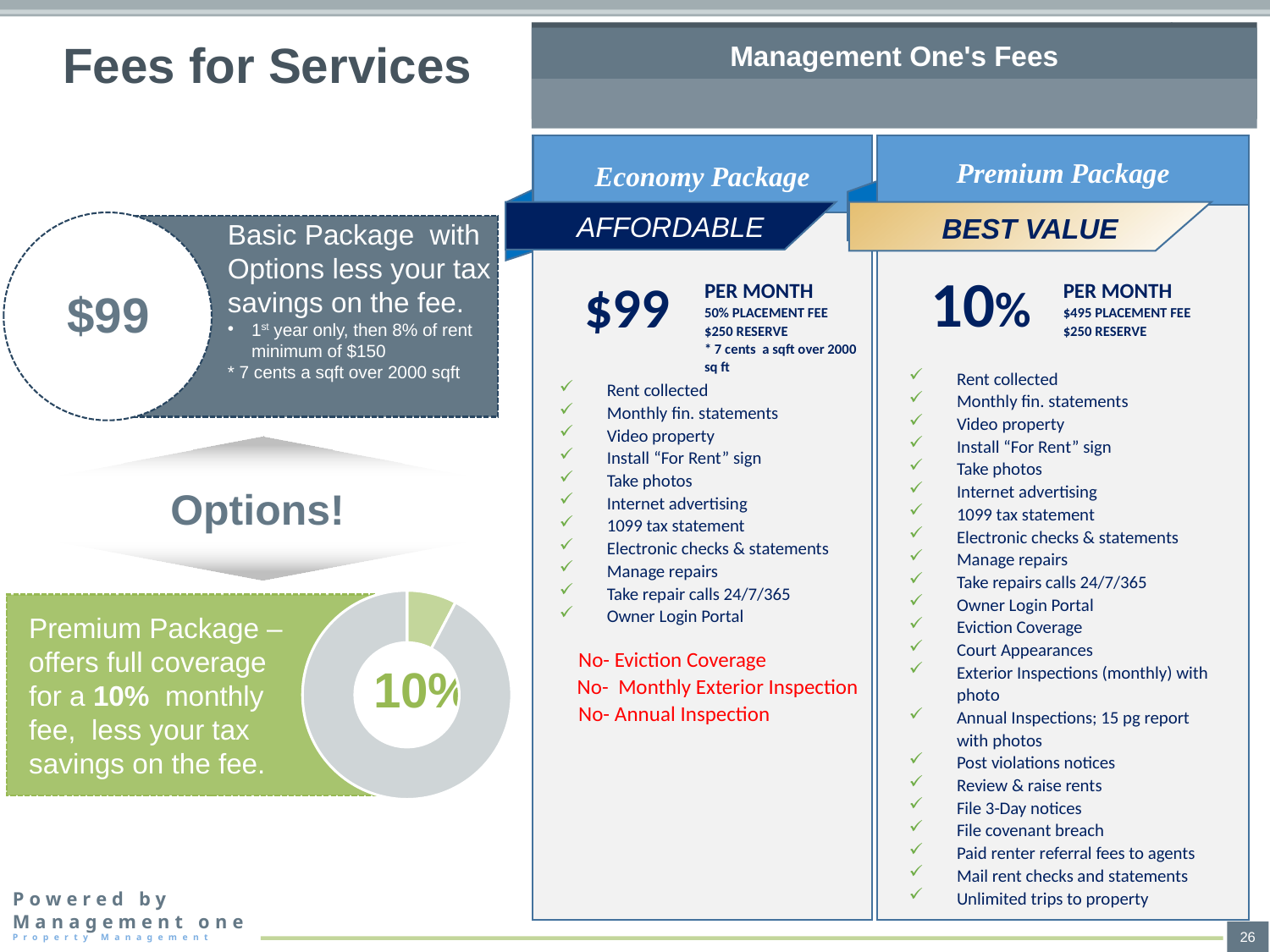
What value is printed in the centre of the doughnut chart? 10% What colour is the smaller slice of the doughnut chart? green How many slices does the doughnut chart have? 2 Which slice of the doughnut chart is the smallest? the green slice What monthly fee does the doughnut chart illustrate for the Premium Package? 10% In the doughnut chart, which slice is larger, the green one or the grey one? grey What share of the doughnut chart does the green slice represent, according to the label in the centre? 10% What kind of chart is shown at the bottom left of the slide? doughnut chart